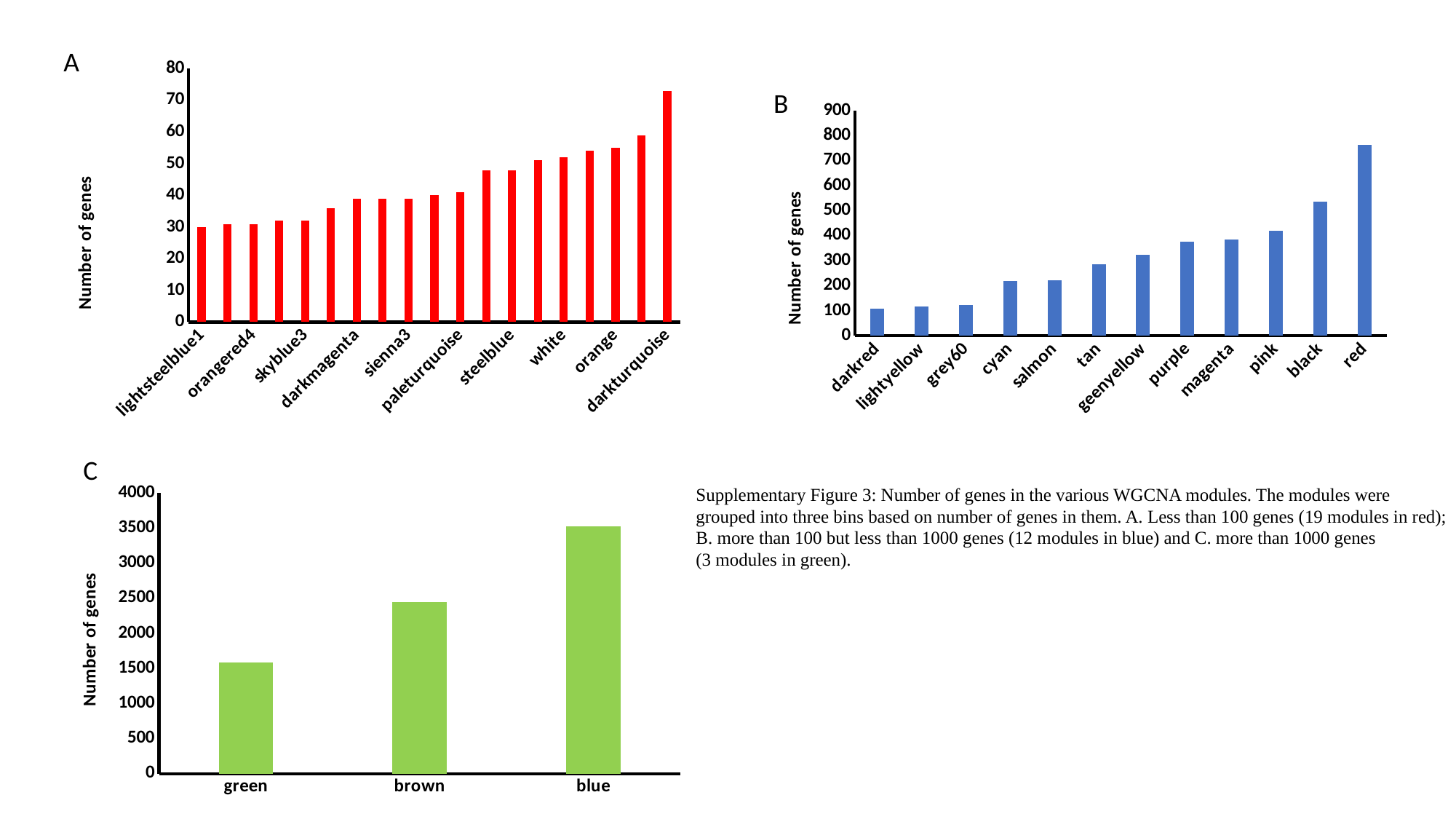
In chart C (bottom left), which module has the highest number of genes? blue In chart A (top left), which module has the highest number of genes? darkturquoise In chart A (top left), is the value for lightsteelblue1 greater or less than 40? less In chart A (top left), do the bar values rise or fall from left to right along the x axis? rise In chart B (top right), how many modules (bars) are plotted? 12 In chart B (top right), which module has the lowest number of genes? darkred In chart C (bottom left), is the value for brown greater or less than 2000? greater What kind of chart is chart C (bottom left)? bar chart In chart B (top right), which module has the highest number of genes? red In chart B (top right), which has more genes, purple or lightyellow? purple In chart A (top left), is the value for darkturquoise greater or less than 70? greater